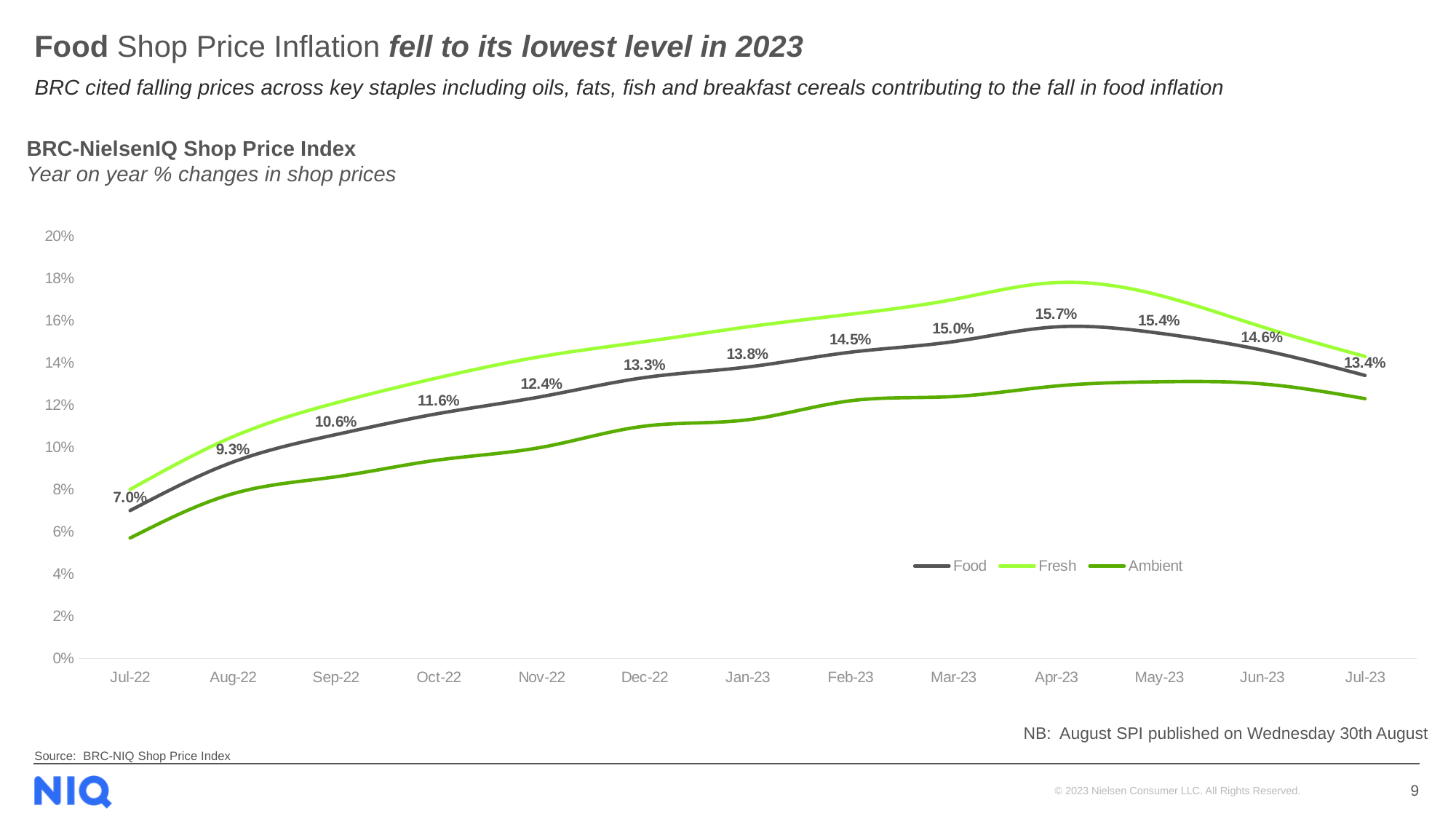
In which month is the Food series at its lowest value? Jul-22 What is the Food value for Jul-23? 13.4% In which month does the Food series reach its highest value? Apr-23 What is the difference between the Food values for Apr-23 and Jul-23? 2.3% How many series does the legend list? 3 Is the Ambient value for Jul-22 greater or less than 6%? less Which is larger, the Food value for Dec-22 or for Mar-23? Mar-23 What is the Food value for Apr-23? 15.7% What kind of chart is shown on the slide? Line chart How many months are shown on the x axis? 13 Is the Fresh value for Apr-23 greater or less than 16%? greater What is the Food value for Jul-22? 7.0%